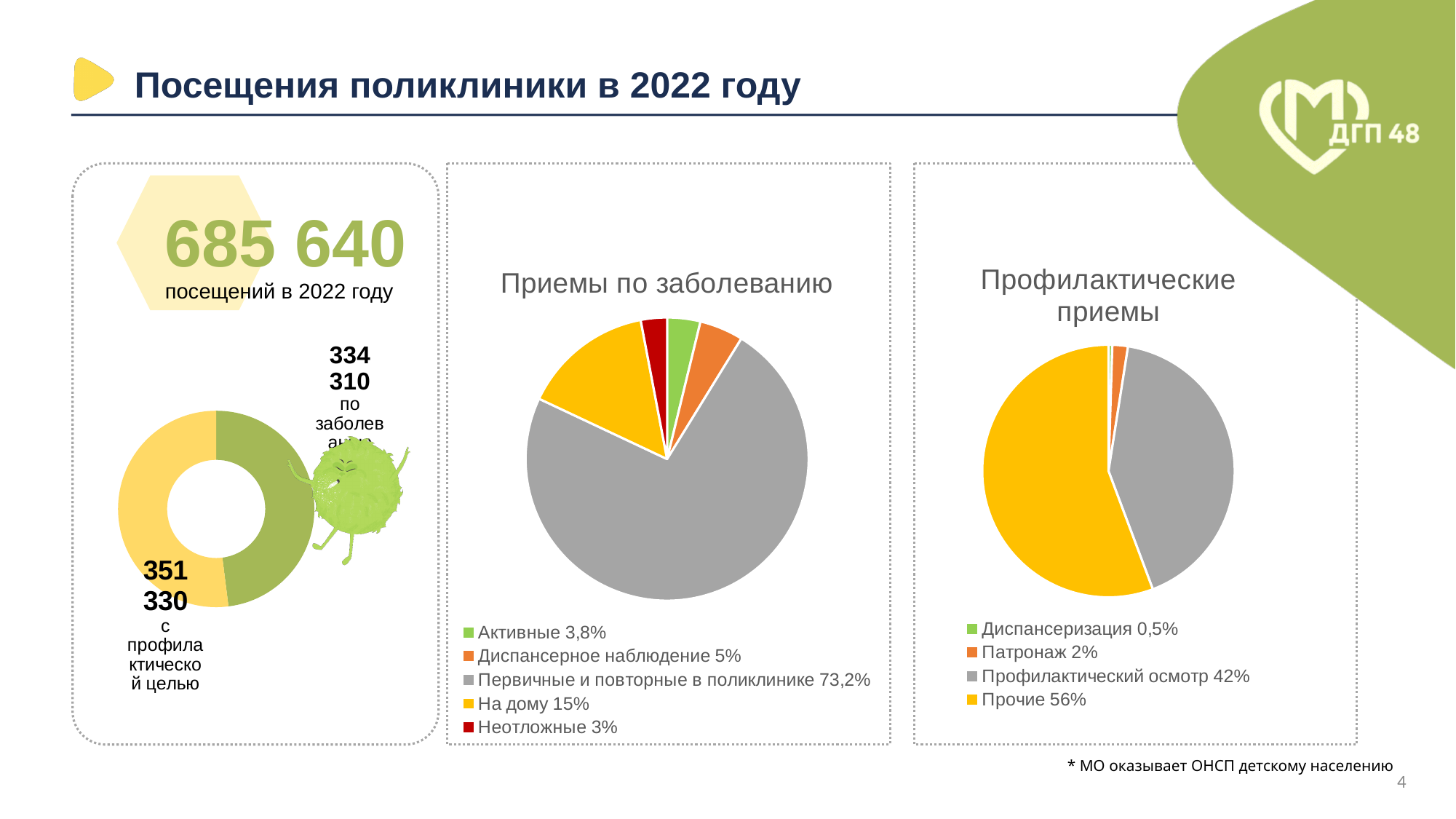
In the pie chart titled "Профилактические приемы", what share is shown for "Профилактический осмотр"? 42% What kind of chart is the chart on the left of the slide showing 334 310 and 351 330? Donut chart In the pie chart titled "Профилактические приемы", how many categories does the legend list? 4 In the pie chart titled "Профилактические приемы", which category has the smallest share? Диспансеризация In the pie chart titled "Приемы по заболеванию", which category has the smallest share? Неотложные In the donut chart on the left of the slide, what value is shown for visits "по заболеванию"? 334 310 In the pie chart titled "Профилактические приемы", which is larger: the share of "Патронаж" or the share of "Диспансеризация"? Патронаж In the pie chart titled "Приемы по заболеванию", what share is shown for "На дому"? 15% In the pie chart titled "Приемы по заболеванию", what is the difference between the shares of "На дому" and "Неотложные"? 12% In the pie chart titled "Приемы по заболеванию", how many categories does the legend list? 5 In the pie chart titled "Профилактические приемы", which category has the largest share? Прочие In the pie chart titled "Приемы по заболеванию", which category has the largest share? Первичные и повторные в поликлинике